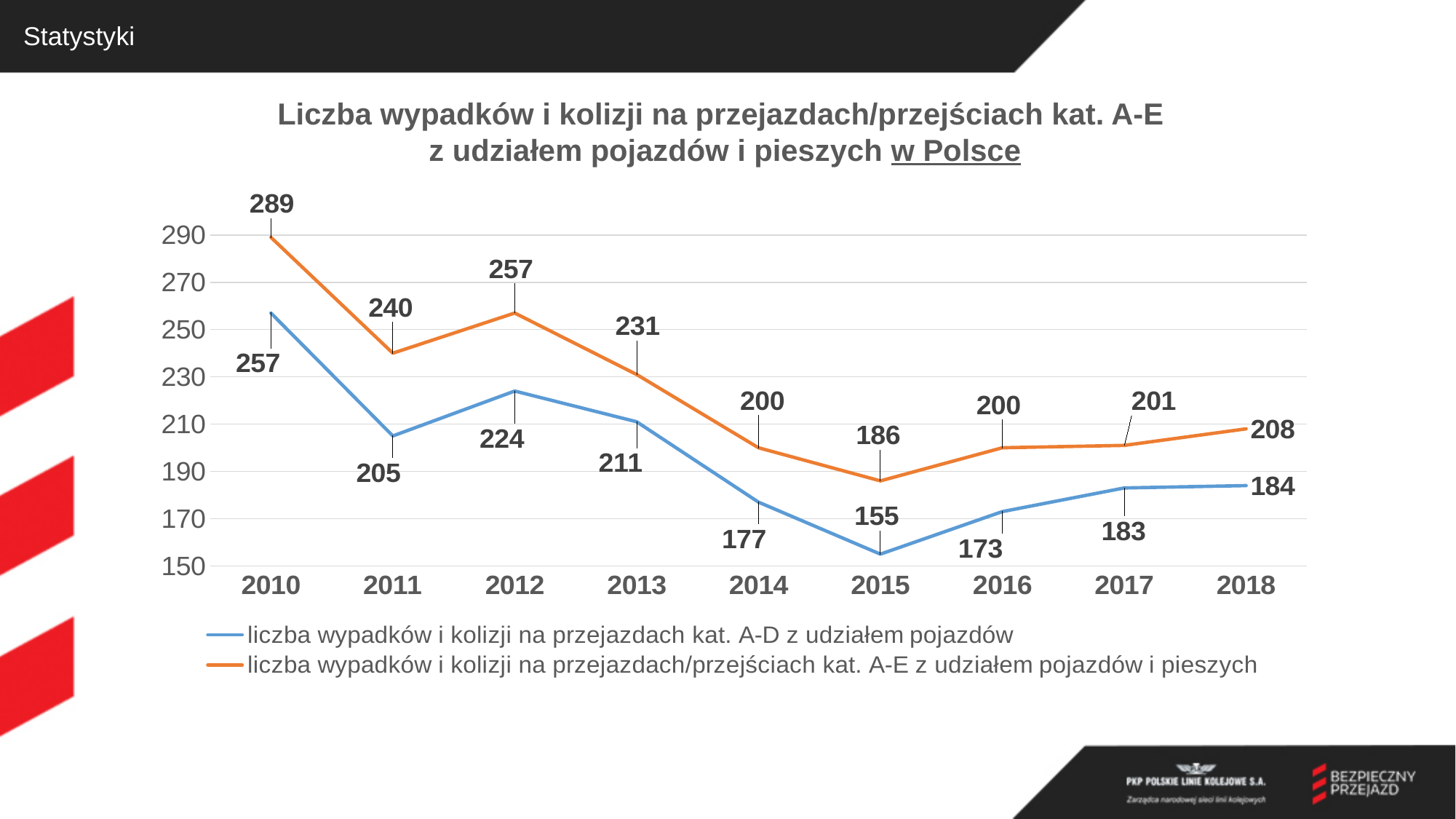
What is the value for 2010 in the series 'liczba wypadków i kolizji na przejazdach/przejściach kat. A-E z udziałem pojazdów i pieszych'? 289 What is the value for 2015 in the series 'liczba wypadków i kolizji na przejazdach kat. A-D z udziałem pojazdów'? 155 What type of chart is shown on the slide? line chart What is the difference between the two series in 2012? 33 In which year is the series 'liczba wypadków i kolizji na przejazdach/przejściach kat. A-E z udziałem pojazdów i pieszych' at its highest? 2010 Does the series 'liczba wypadków i kolizji na przejazdach/przejściach kat. A-E z udziałem pojazdów i pieszych' generally rise or fall from 2010 to 2015? fall In which year is the series 'liczba wypadków i kolizji na przejazdach kat. A-D z udziałem pojazdów' at its lowest? 2015 How many years are plotted along the x axis? 9 What colour is the line for the series 'liczba wypadków i kolizji na przejazdach kat. A-D z udziałem pojazdów'? blue Which is larger: the value for 2016 or the value for 2017 in the series 'liczba wypadków i kolizji na przejazdach kat. A-D z udziałem pojazdów'? 2017 How many series does the legend list? 2 What is the value for 2018 in the series 'liczba wypadków i kolizji na przejazdach/przejściach kat. A-E z udziałem pojazdów i pieszych'? 208